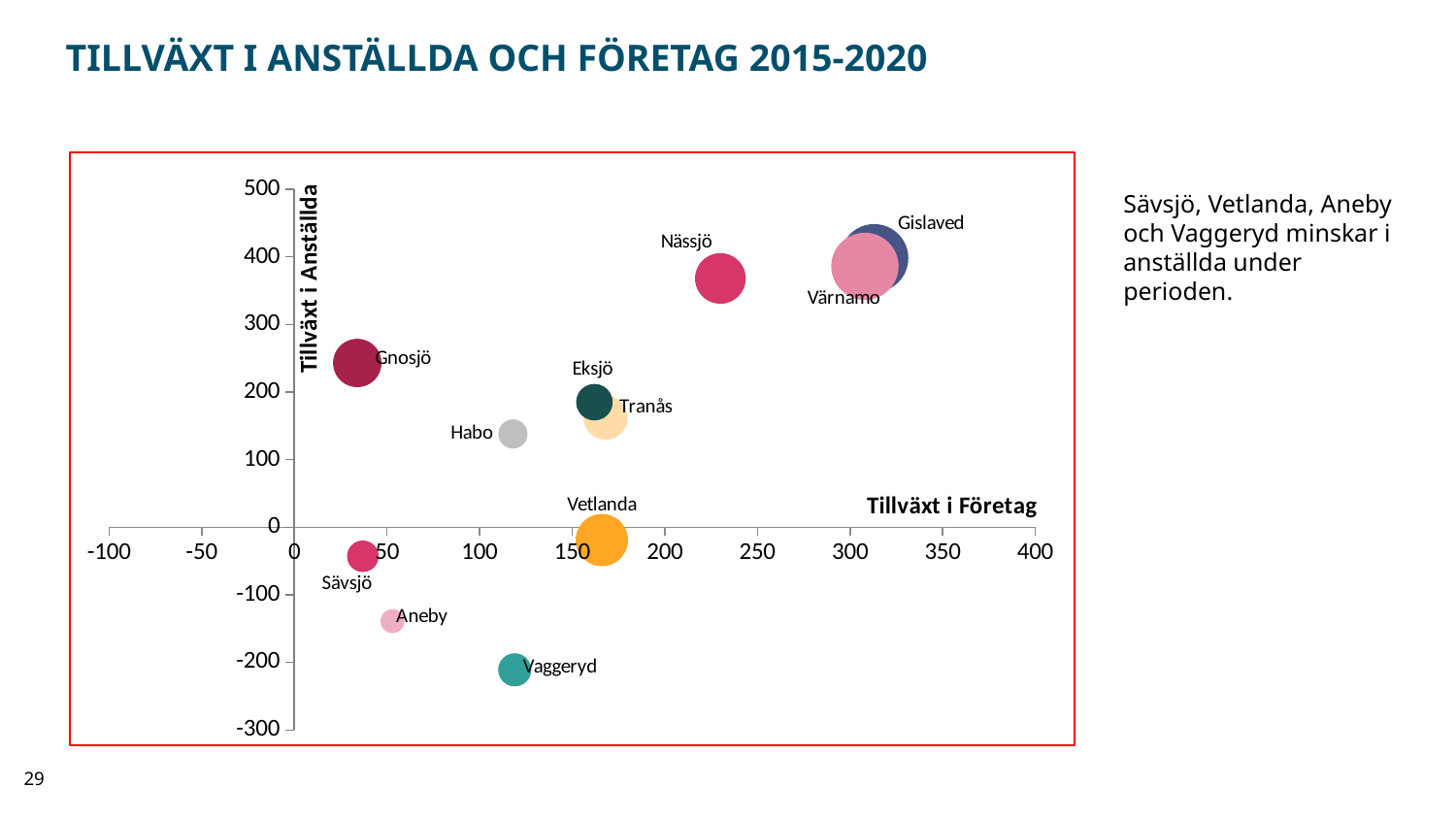
Which has the higher growth in employees, Nässjö or Gnosjö? Nässjö Is the growth in employees for Habo greater or less than 200? less Is the growth in companies (Tillväxt i Företag) for Gnosjö greater or less than 50? less Is the growth in employees for Nässjö greater or less than 300? greater Which municipality has the lowest growth in employees (Tillväxt i Anställda)? Vaggeryd Which has the higher growth in employees, Aneby or Vaggeryd? Aneby What kind of chart is shown on the slide? Bubble chart What is the label of the vertical axis of the chart? Tillväxt i Anställda How many municipalities are plotted in the chart? 11